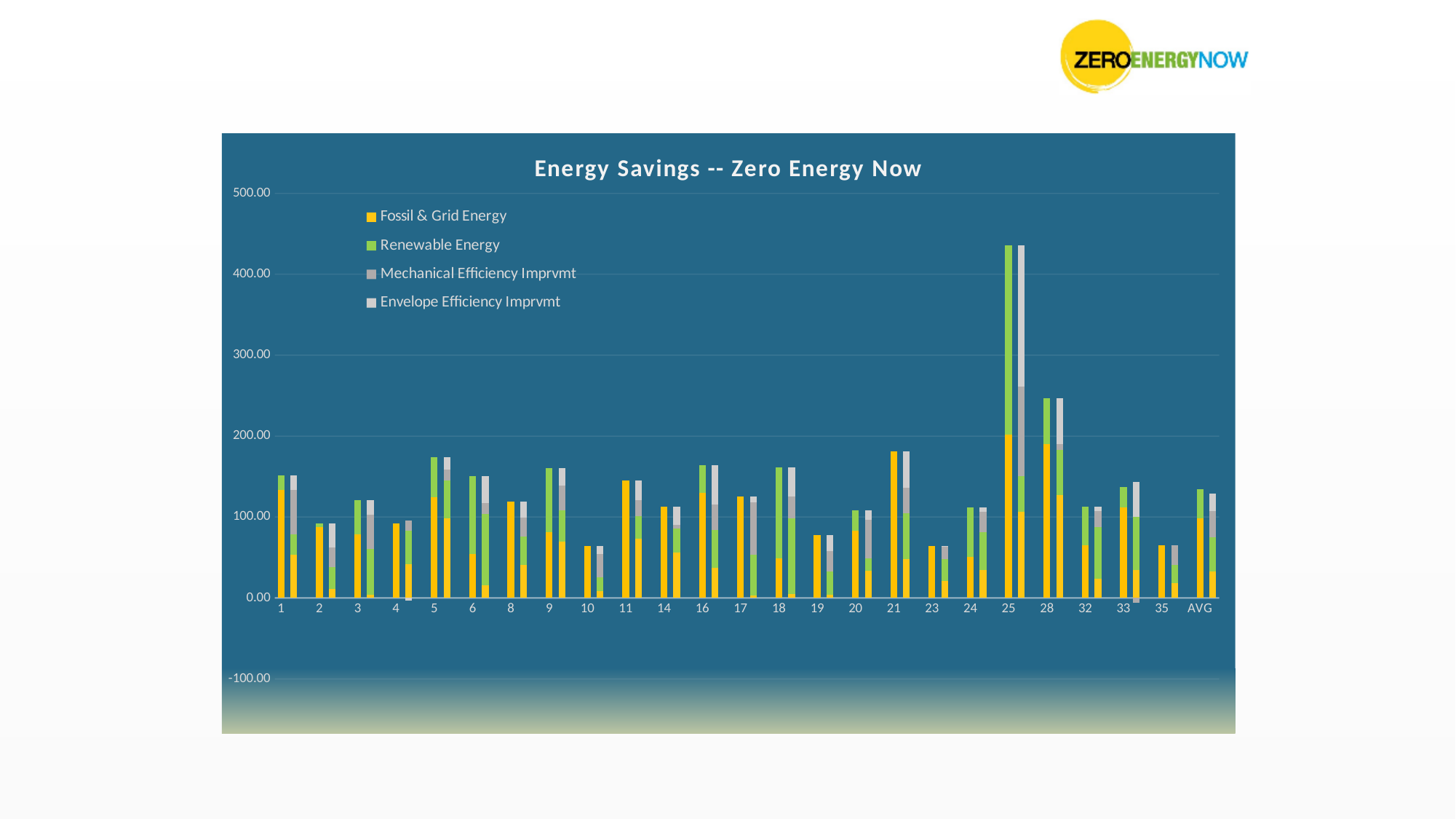
What kind of chart is shown on the slide? Stacked bar chart Is the total value for category 28 greater or less than 200? greater Which has the taller stacked bar, category 25 or category 28? 25 Is the total value for category 25 greater or less than 400? greater What is the title of the chart? Energy Savings -- Zero Energy Now Is the total value for category 19 greater or less than 100? less Which has the taller stacked bar, category 9 or category 10? 9 Which series is shown in yellow in the legend? Fossil & Grid Energy Which category has the tallest stacked bar? 25 How many categories are shown along the x axis? 25 How many series does the legend list? 4